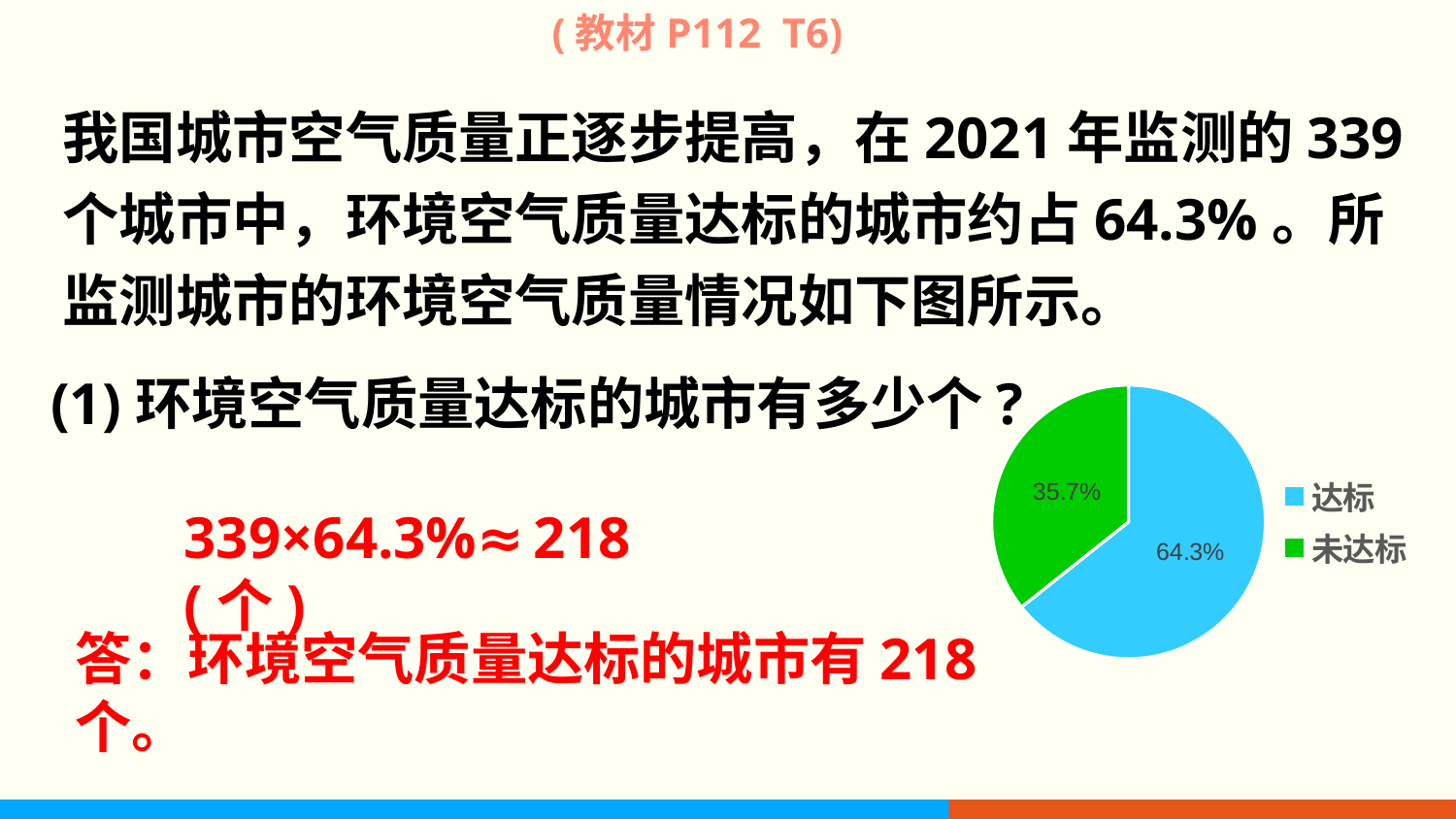
Which slice of the pie is the smallest? 未达标 What share of the pie does 达标 take? 64.3% What is the difference in percentage points between the 达标 and 未达标 slices? 28.6 What share of the pie does 未达标 take? 35.7% How many entries does the legend list? 2 How many slices does the pie chart have? 2 Which slice of the pie is the largest? 达标 What kind of chart is shown on the slide? pie chart Which is larger, the 达标 slice or the 未达标 slice? 达标 What colour is the 达标 slice? blue What is the total of the two slice percentages shown on the pie? 100% What colour is the 未达标 slice? green